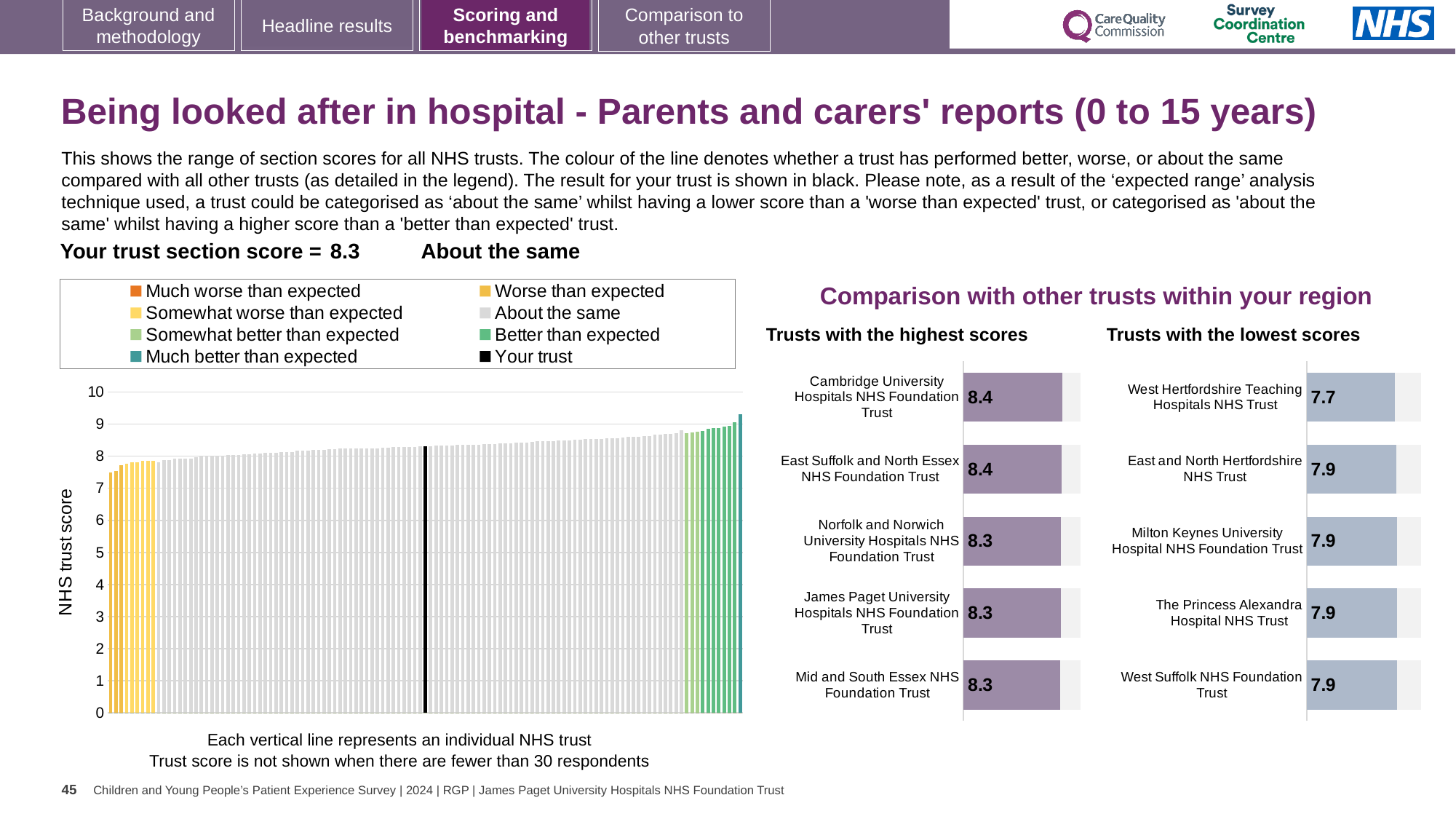
In the large chart on the left, do the trust scores rise or fall from left to right along the x axis? Rise In the 'Trusts with the highest scores' chart, what is the score for Cambridge University Hospitals NHS Foundation Trust? 8.4 What kind of chart is the large chart on the left showing NHS trust scores? Bar chart What is the difference between the score for Cambridge University Hospitals NHS Foundation Trust in the highest scores chart and West Hertfordshire Teaching Hospitals NHS Trust in the lowest scores chart? 0.7 In the 'Trusts with the highest scores' chart, what is the score for Mid and South Essex NHS Foundation Trust? 8.3 In the 'Trusts with the lowest scores' chart, which trust has the lowest score? West Hertfordshire Teaching Hospitals NHS Trust How many trusts are listed in the 'Trusts with the highest scores' chart? 5 How many entries does the legend of the large chart on the left list? 8 In the 'Trusts with the lowest scores' chart, what is the score for West Hertfordshire Teaching Hospitals NHS Trust? 7.7 In the 'Trusts with the lowest scores' chart, what is the score for Milton Keynes University Hospital NHS Foundation Trust? 7.9 Which is larger: the score for East Suffolk and North Essex NHS Foundation Trust in the highest scores chart or the score for West Suffolk NHS Foundation Trust in the lowest scores chart? East Suffolk and North Essex NHS Foundation Trust How many trusts are listed in the 'Trusts with the lowest scores' chart? 5